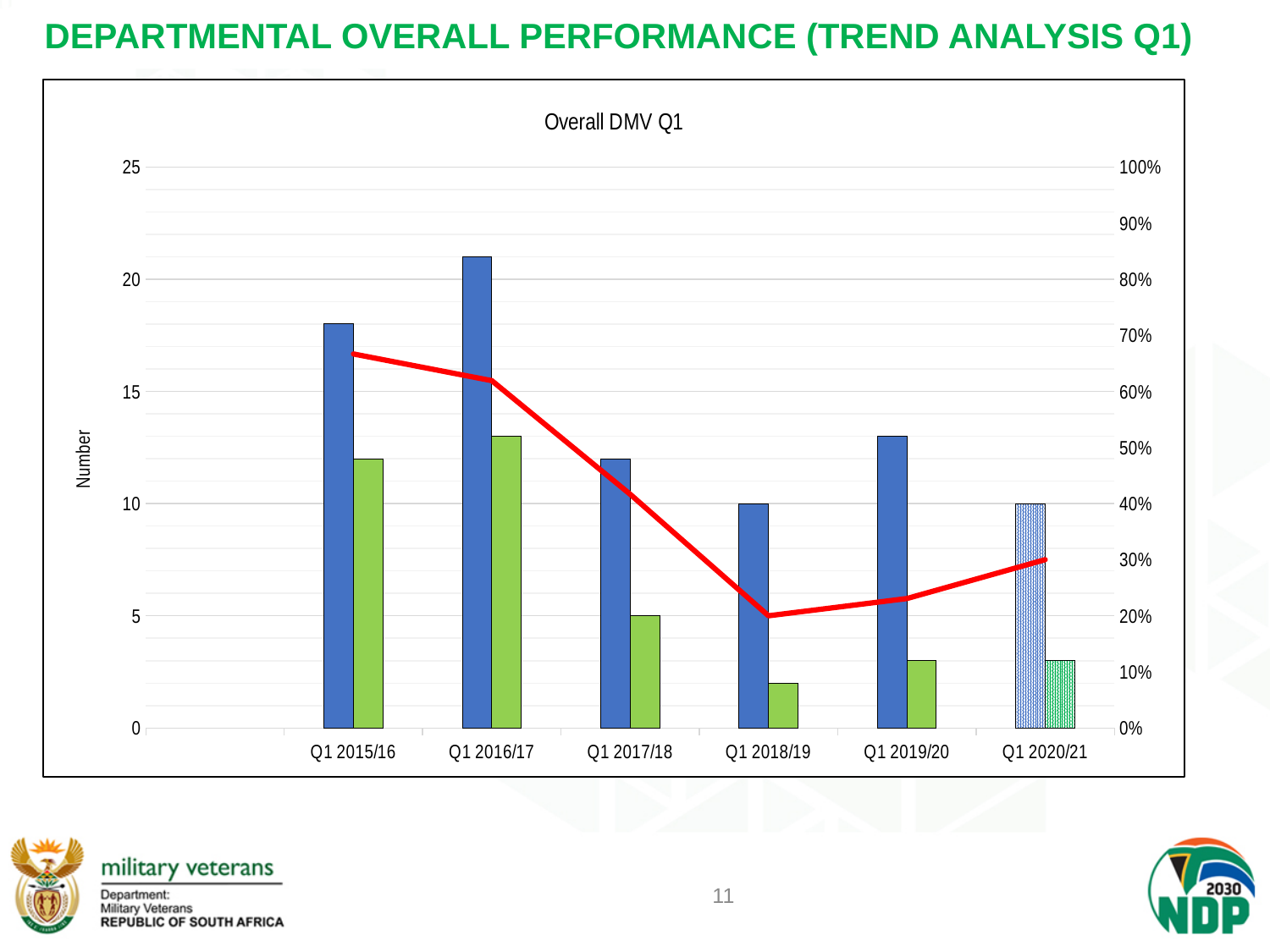
What is the value of the blue bar for Q1 2018/19? 10 What percentage does the red line show for Q1 2018/19? 20% Which quarter has the shortest green bar? Q1 2018/19 Does the red line rise or fall from Q1 2015/16 to Q1 2018/19? fall Is the blue bar for Q1 2015/16 greater or less than 15? greater How many quarters are shown along the x axis? 6 What is the value of the green bar for Q1 2017/18? 5 Which quarter has the tallest blue bar? Q1 2016/17 What is the title of the chart? Overall DMV Q1 Is the red line value for Q1 2015/16 greater or less than 60%? greater What is the label on the left vertical axis? Number What kind of chart is shown on the slide? bar chart with a line